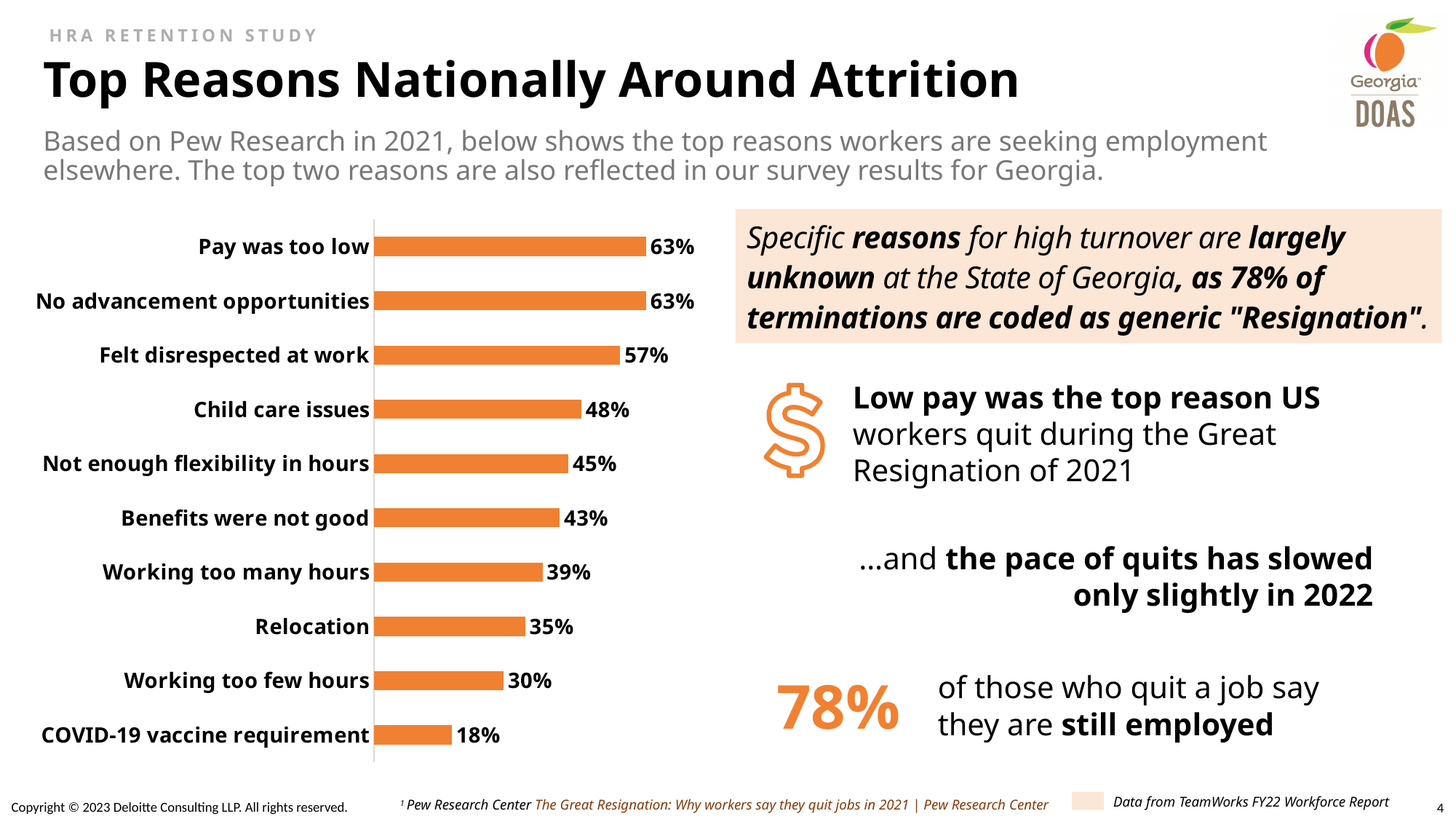
What is the difference between the values for Pay was too low and Benefits were not good? 20% Which category has the lowest value? COVID-19 vaccine requirement How many categories are shown in the chart? 10 What is the value for COVID-19 vaccine requirement? 18% Which is larger, the value for Not enough flexibility in hours or the value for Relocation? Not enough flexibility in hours Do the values rise or fall going from the top bar to the bottom bar? Fall What is the value for Relocation? 35% What is the difference between the values for Working too many hours and Working too few hours? 9% What colour are the bars in the chart? Orange What is the value for Felt disrespected at work? 57% What kind of chart is shown on the slide? Bar chart What is the value for Child care issues? 48%